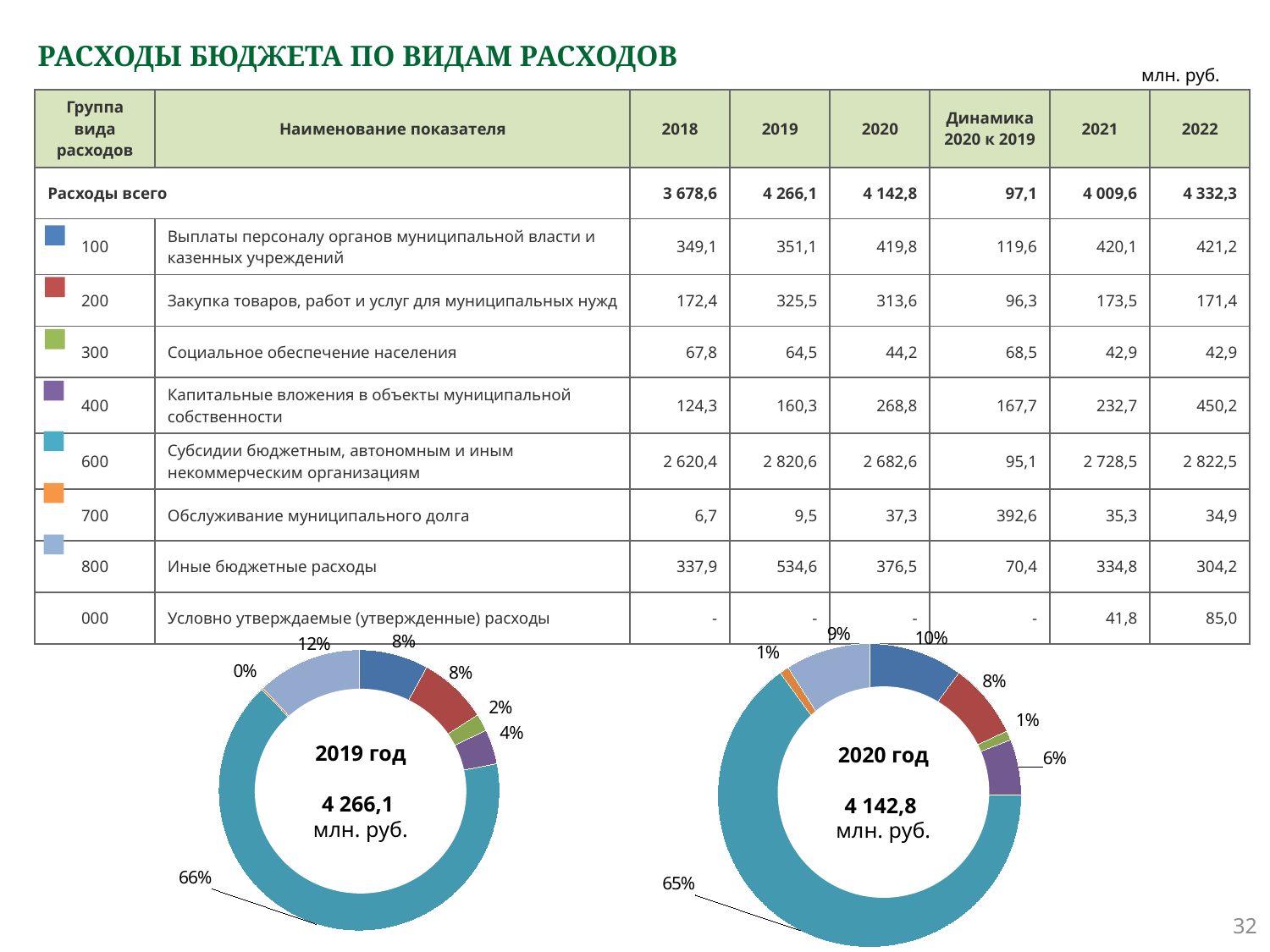
Which slice is the largest in the "2020 год" chart? The teal slice (group 600, субсидии бюджетным, автономным и иным некоммерческим организациям), 65% What total value is printed in the centre of the "2020 год" chart? 4 142,8 млн. руб. In the "2020 год" chart, what share is shown for the dark blue slice (group 100 — выплаты персоналу)? 10% In the "2019 год" chart, what share is shown for the light blue slice (group 800 — иные бюджетные расходы)? 12% In the "2019 год" chart, what share does the largest slice (teal, group 600 — субсидии бюджетным, автономным и иным некоммерческим организациям) have? 66% Which is larger: the share of the purple slice (group 400) in the "2019 год" chart or in the "2020 год" chart? 2020 год (6% vs 4%) What total value is printed in the centre of the "2019 год" chart? 4 266,1 млн. руб. How many slices does the "2020 год" chart have? 7 What kind of chart is the "2019 год" chart? Doughnut (pie) chart